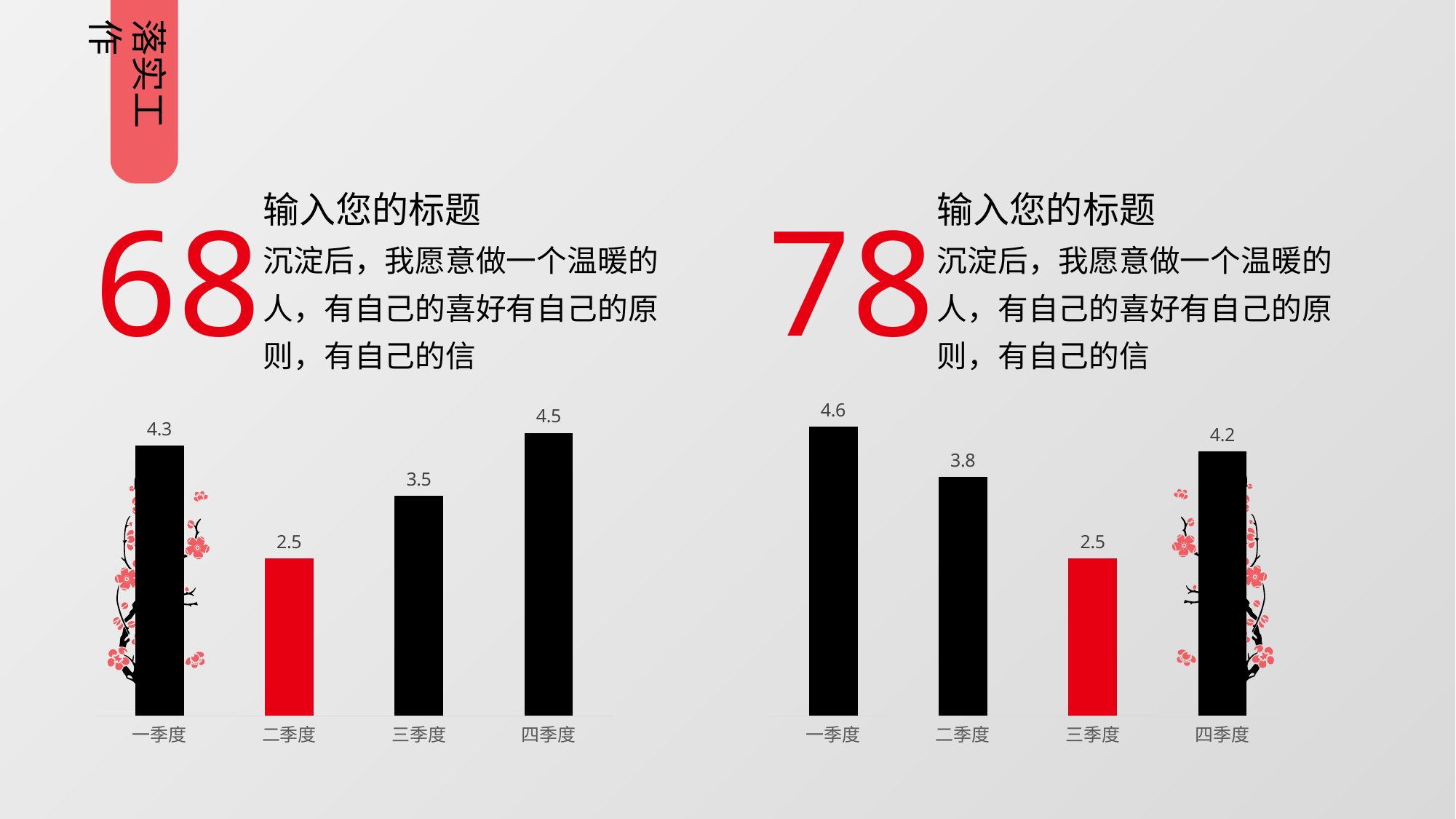
How many categories does the left chart show? 4 In the right chart, what is the value for 二季度? 3.8 In the right chart, which quarter has the lowest value? 三季度 What kind of chart is the right chart? bar chart In the left chart, which quarter has the highest value? 四季度 In the right chart, what is the value for 四季度? 4.2 In the left chart, what is the value for 一季度? 4.3 In the left chart, what is the value for 二季度? 2.5 In the right chart, which is larger, the value for 一季度 or the value for 四季度? 一季度 In the right chart, which quarter has the highest value? 一季度 In the left chart, what is the difference between the values for 四季度 and 三季度? 1.0 In the left chart, which quarter has the lowest value? 二季度